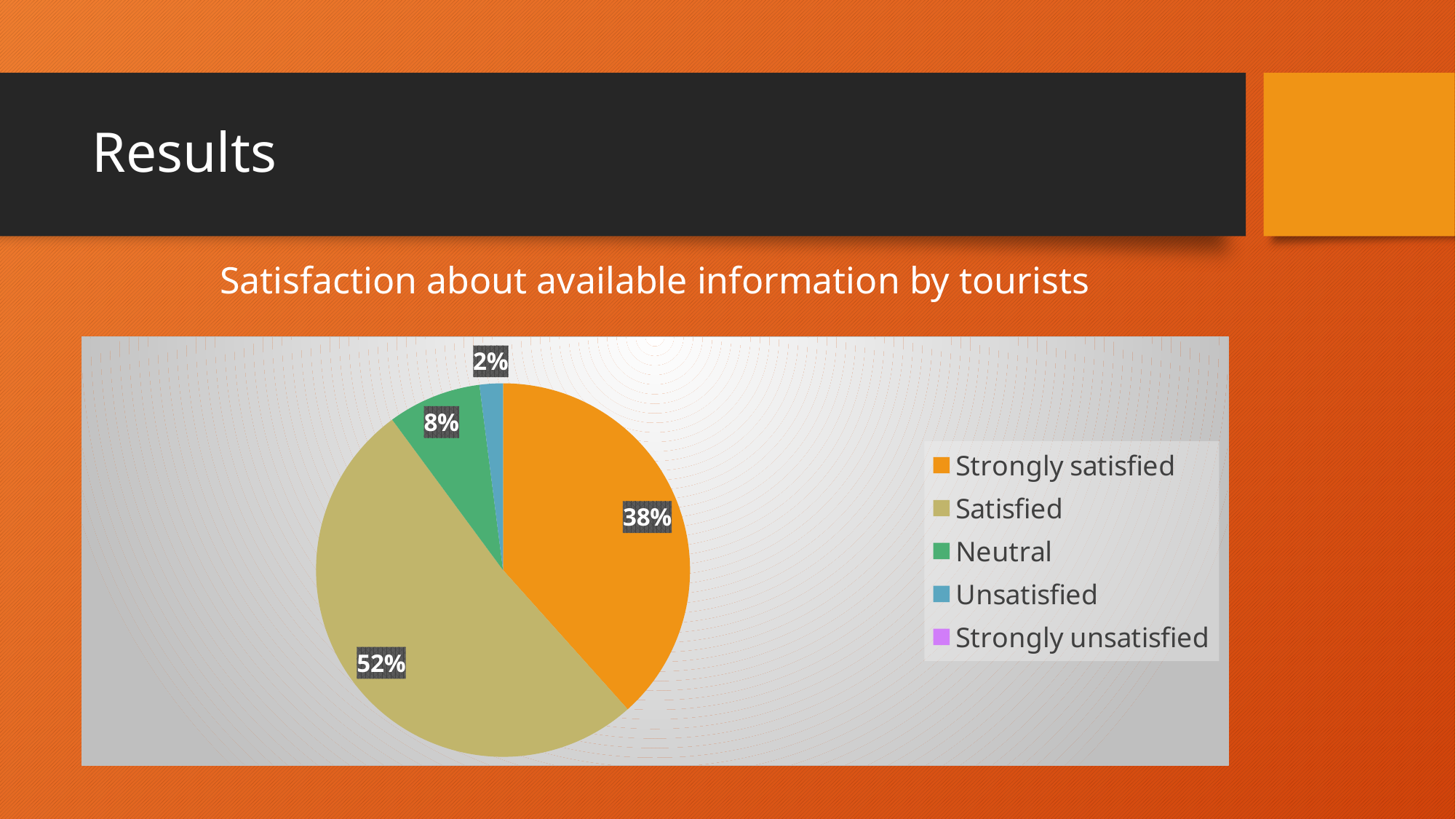
What percentage of tourists were Satisfied? 52% What percentage of tourists were Strongly satisfied? 38% Which is larger, the share for Neutral or the share for Unsatisfied? Neutral What percentage of tourists were Neutral? 8% What is the difference in percentage points between Satisfied and Strongly satisfied? 14 Which category has the largest share of the pie? Satisfied What is the title of the chart? Satisfaction about available information by tourists What type of chart is shown on the slide? Pie chart What colour is the slice for Strongly satisfied? Orange Which labelled slice has the smallest share of the pie? Unsatisfied What percentage of tourists were Unsatisfied? 2% How many entries does the legend list? 5